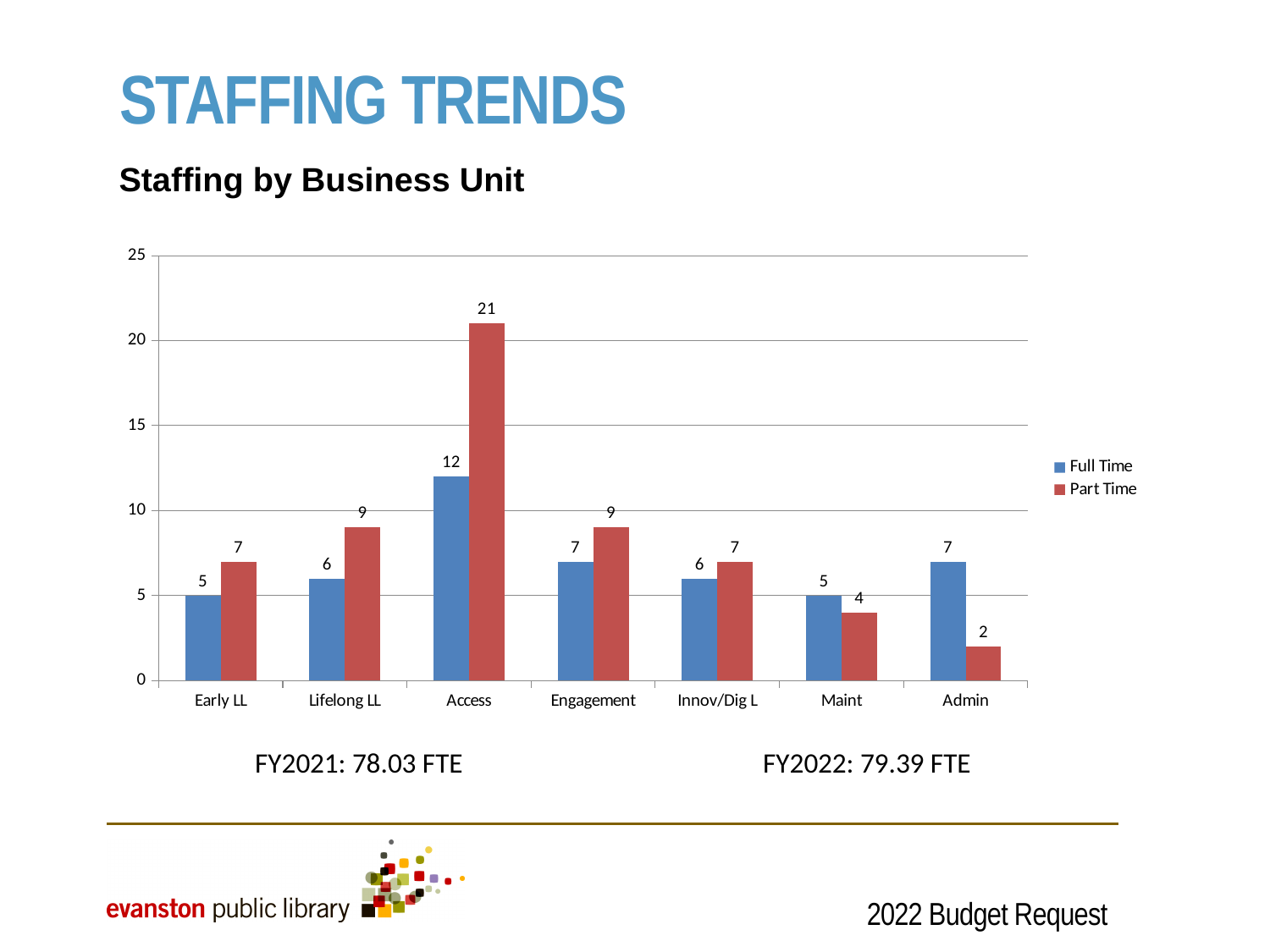
Which business unit has the lowest Part Time value? Admin How many series does the legend list? 2 Which is larger for Maint, the Full Time value or the Part Time value? Full Time Which business unit has the highest Part Time value? Access What kind of chart is shown on the slide? bar chart What is the Full Time value for Access? 12 What is the Part Time value for Admin? 2 What is the Part Time value for Lifelong LL? 9 What is the difference between the Part Time and Full Time values for Access? 9 How many business units are shown on the x axis? 7 Is the Part Time value for Access greater or less than 20? greater What is the title of the chart? Staffing by Business Unit